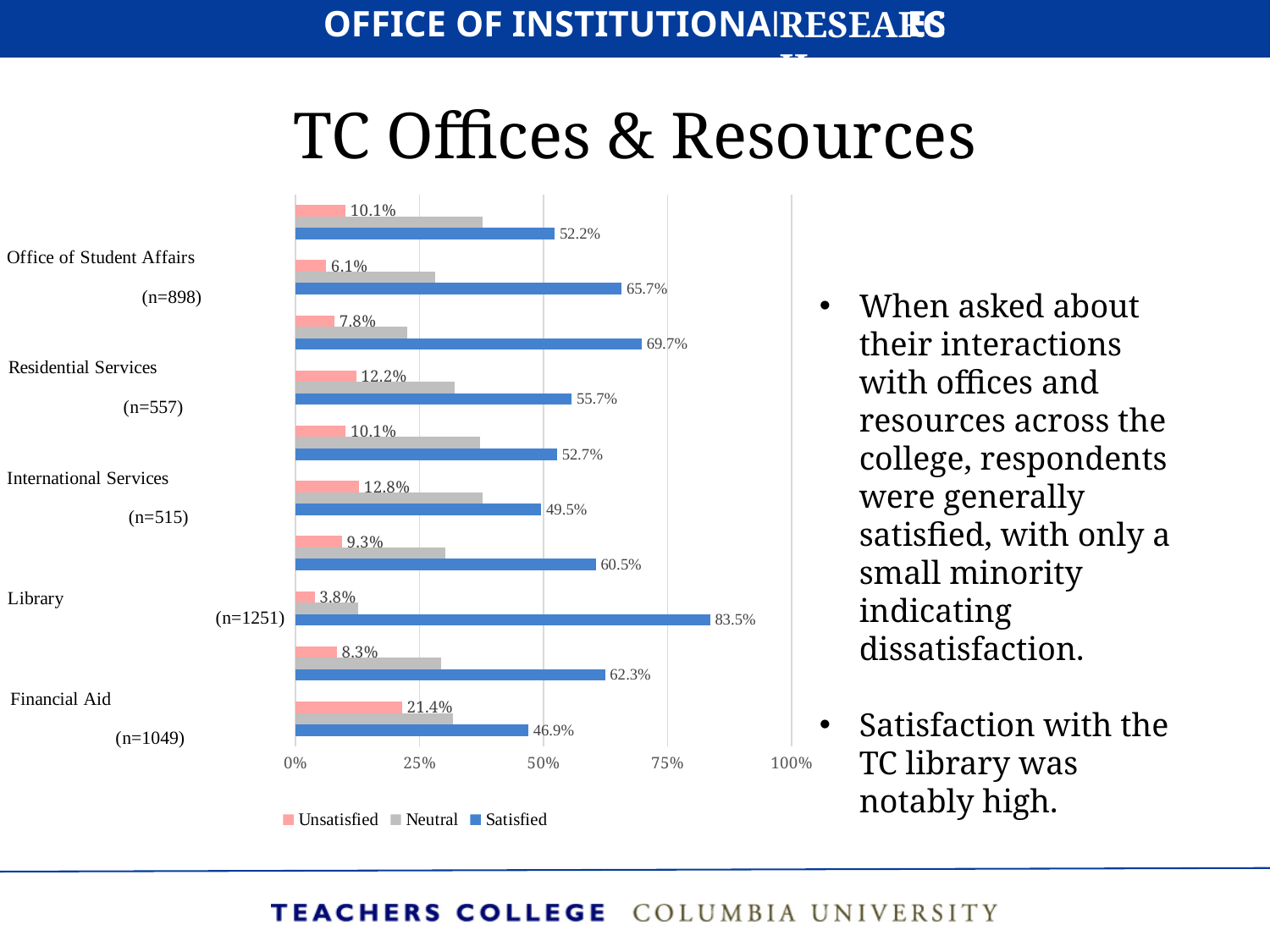
What is the Satisfied value for the Library (n=1251)? 83.5% What type of chart is shown on the slide? bar chart What is the lowest Unsatisfied value shown in the chart? 3.8% What is the lowest Satisfied value shown in the chart? 46.9% What is the highest Unsatisfied value shown in the chart? 21.4% How many series does the legend list? 3 How many groups of bars are plotted in the chart? 10 What is the highest Satisfied value shown in the chart? 83.5% What are the three series named in the legend? Unsatisfied, Neutral, Satisfied What is the maximum value shown on the horizontal axis? 100% Is the Neutral value in the group where Satisfied is 83.5% greater or less than 25%? less What is the difference between the highest Satisfied value (83.5%) and the lowest Satisfied value (46.9%)? 36.6 percentage points